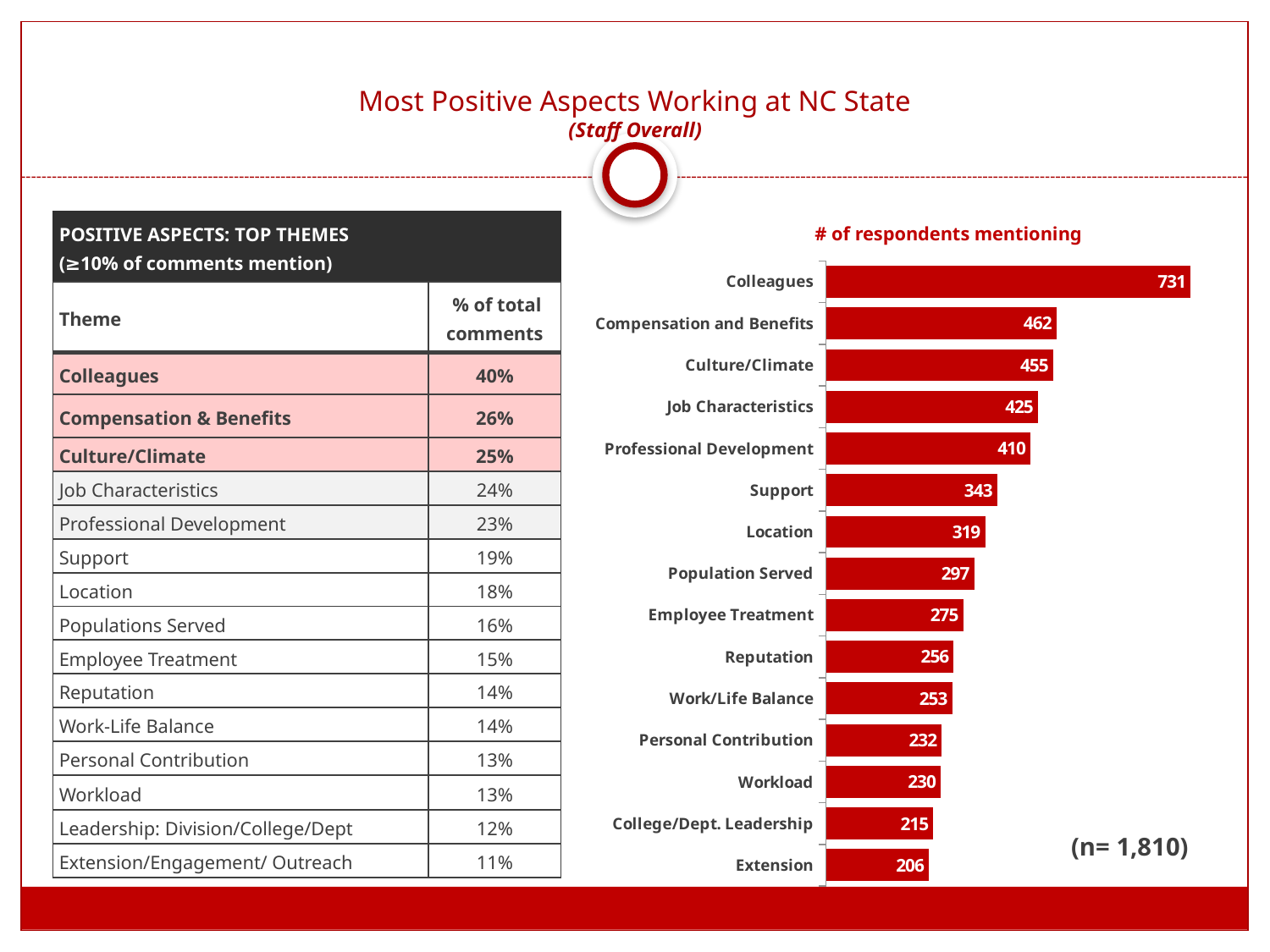
What is the title of the chart? # of respondents mentioning How many respondents mentioned Colleagues? 731 What is the value for Work/Life Balance? 253 What is the difference between the values for Colleagues and Compensation and Benefits? 269 What is the difference between the values for Support and Location? 24 Which category has the highest number of respondents mentioning? Colleagues How many categories are plotted in the chart? 15 What is the value for Professional Development? 410 Do the values rise or fall going down the chart from Colleagues to Extension? fall Which category has the lowest number of respondents mentioning? Extension Which is larger, the value for Job Characteristics or the value for Professional Development? Job Characteristics What kind of chart is shown on the slide? bar chart